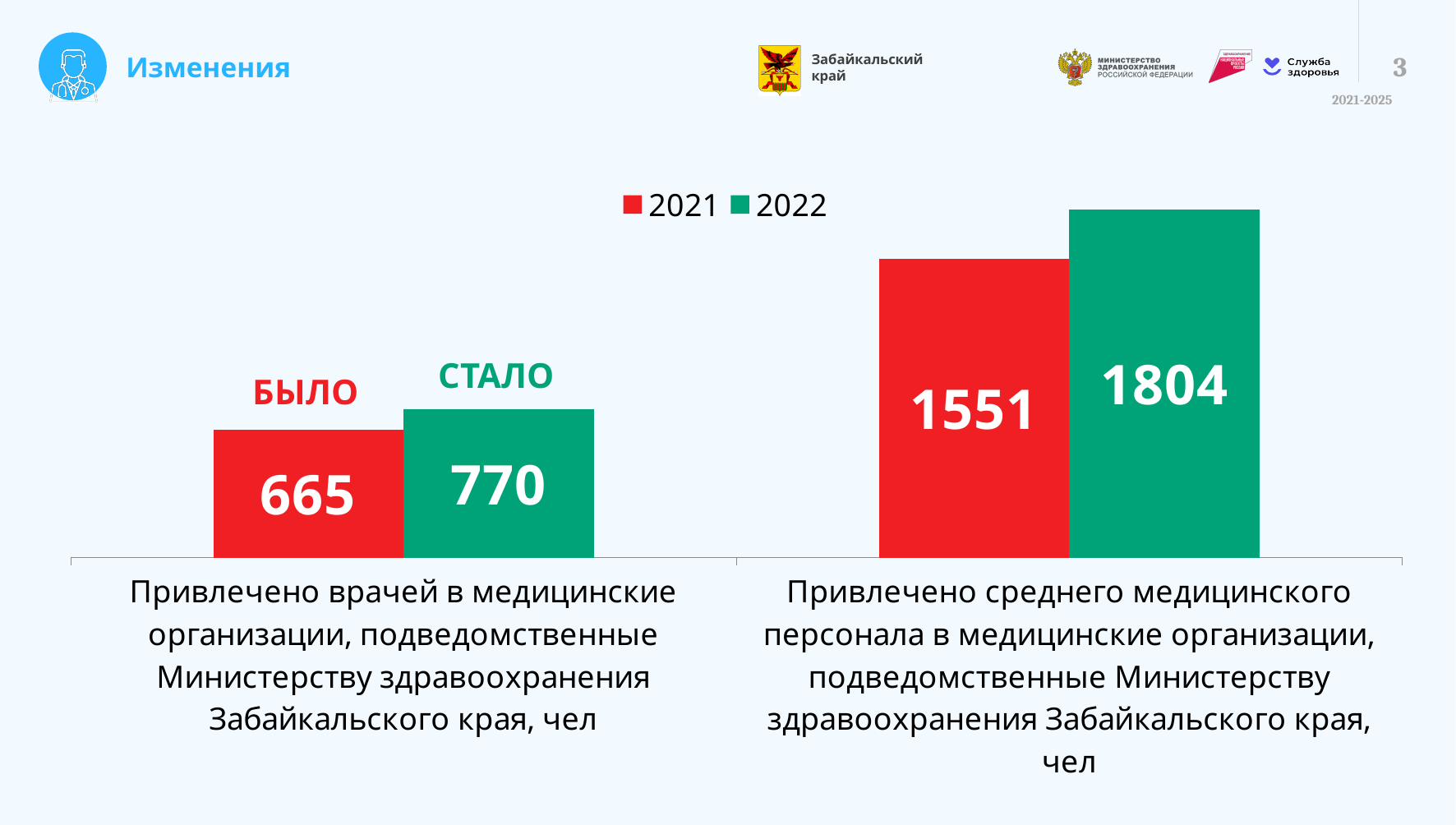
What is the 2022 value for mid-level medical personnel attracted (Привлечено среднего медицинского персонала)? 1804 How many series does the legend list? 2 What is the 2021 value for doctors attracted to medical organizations (Привлечено врачей)? 665 What is the 2021 value for mid-level medical personnel attracted (Привлечено среднего медицинского персонала)? 1551 Which years are listed in the legend? 2021 and 2022 What type of chart is shown on the slide? Bar chart Which is larger: the 2021 value for doctors or the 2022 value for doctors? 2022 (770) By how much did the number of doctors attracted increase from 2021 to 2022? 105 What is the 2022 value for doctors attracted to medical organizations (Привлечено врачей)? 770 By how much did the number of mid-level medical personnel attracted increase from 2021 to 2022? 253 Which category has the highest value in 2022? Привлечено среднего медицинского персонала (mid-level medical personnel) How many categories are shown on the x axis? 2